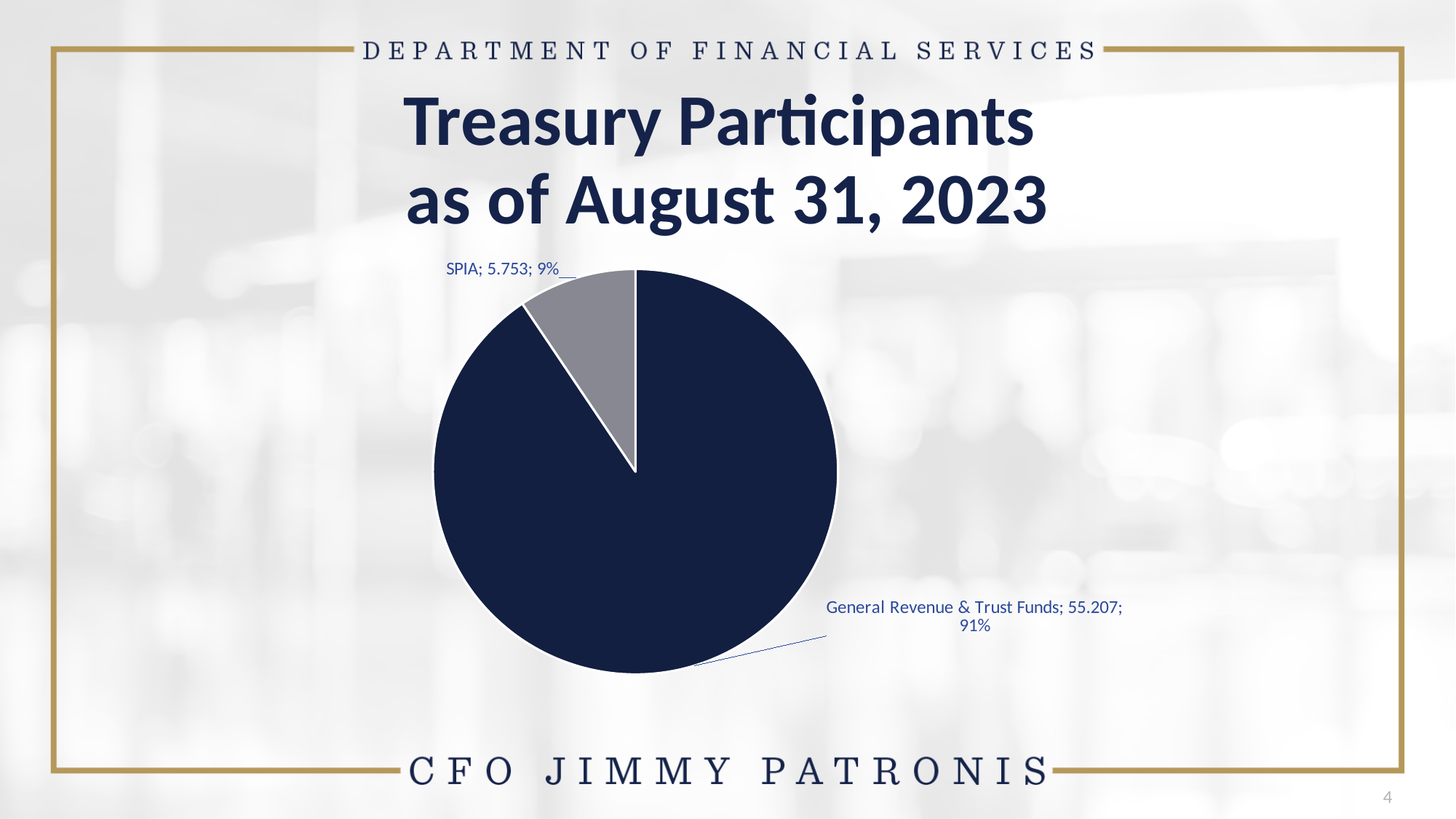
What is the difference between the value for General Revenue & Trust Funds and the value for SPIA? 49.454 What share of the pie does SPIA represent? 9% What is the value for General Revenue & Trust Funds? 55.207 Which category has the largest slice of the pie? General Revenue & Trust Funds Which is larger, the value for SPIA or the value for General Revenue & Trust Funds? General Revenue & Trust Funds What is the value for SPIA? 5.753 What kind of chart is shown on the slide? pie chart Which category has the smallest slice of the pie? SPIA What is the title of the slide containing the pie chart? Treasury Participants as of August 31, 2023 What share of the pie does General Revenue & Trust Funds represent? 91% How many slices does the pie chart have? 2 What colour is the SPIA slice of the pie chart? grey